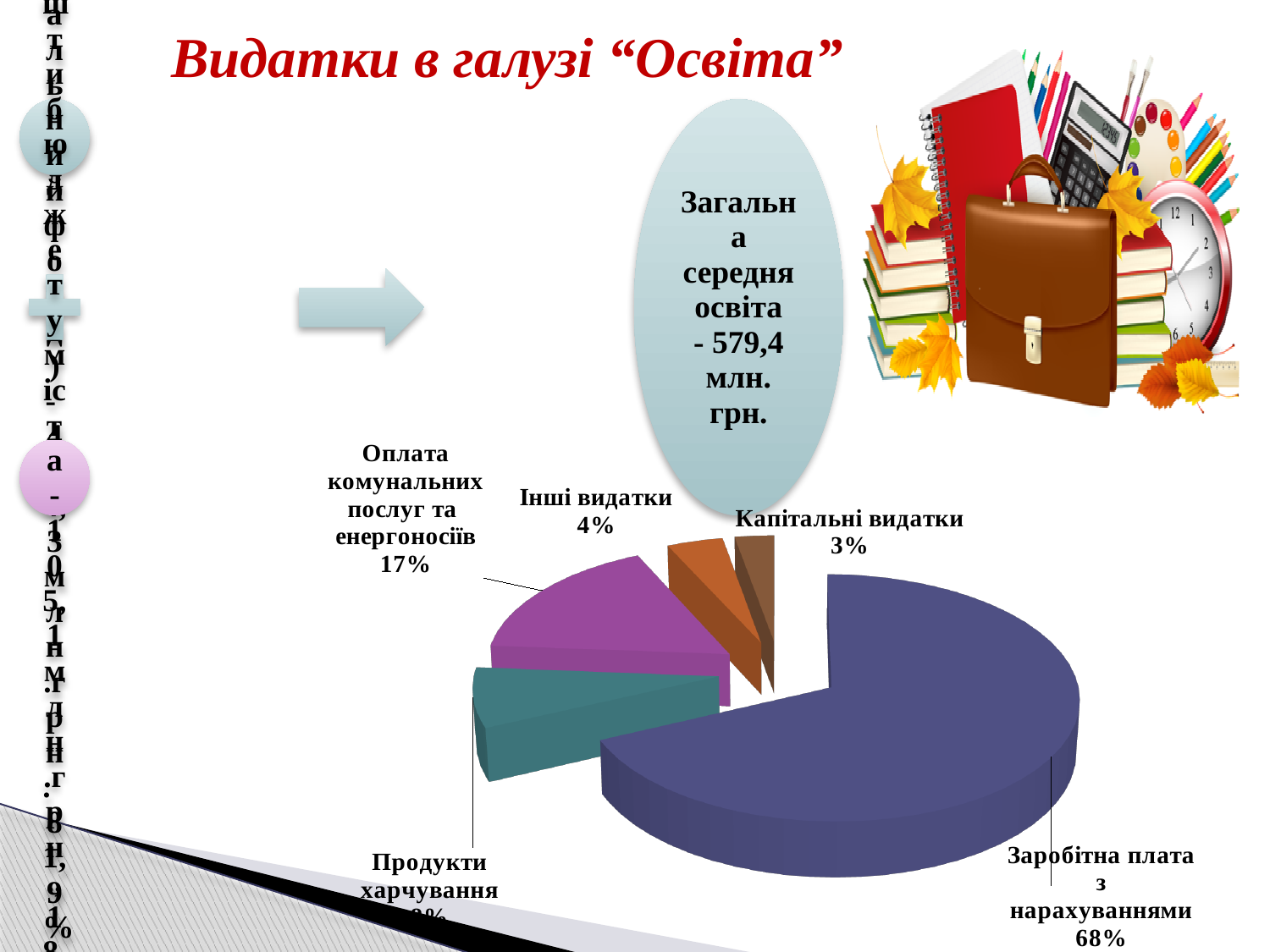
How many slices does the pie chart have? 5 Which category has the smallest slice of the pie? Капітальні видатки What kind of chart is shown on the slide? Pie chart Which category has the largest slice of the pie? Заробітна плата з нарахуваннями What is the value shown for "Інші видатки"? 4% What is the title of the slide? Видатки в галузі "Освіта" What is the value shown for "Оплата комунальних послуг та енергоносіїв"? 17% What is the value shown for "Капітальні видатки"? 3% What share of the pie does "Заробітна плата з нарахуваннями" take? 68% Which is larger, "Інші видатки" or "Капітальні видатки"? Інші видатки What is the difference in percentage points between "Заробітна плата з нарахуваннями" and "Оплата комунальних послуг та енергоносіїв"? 51 percentage points What is the difference in percentage points between "Оплата комунальних послуг та енергоносіїв" and "Інші видатки"? 13 percentage points